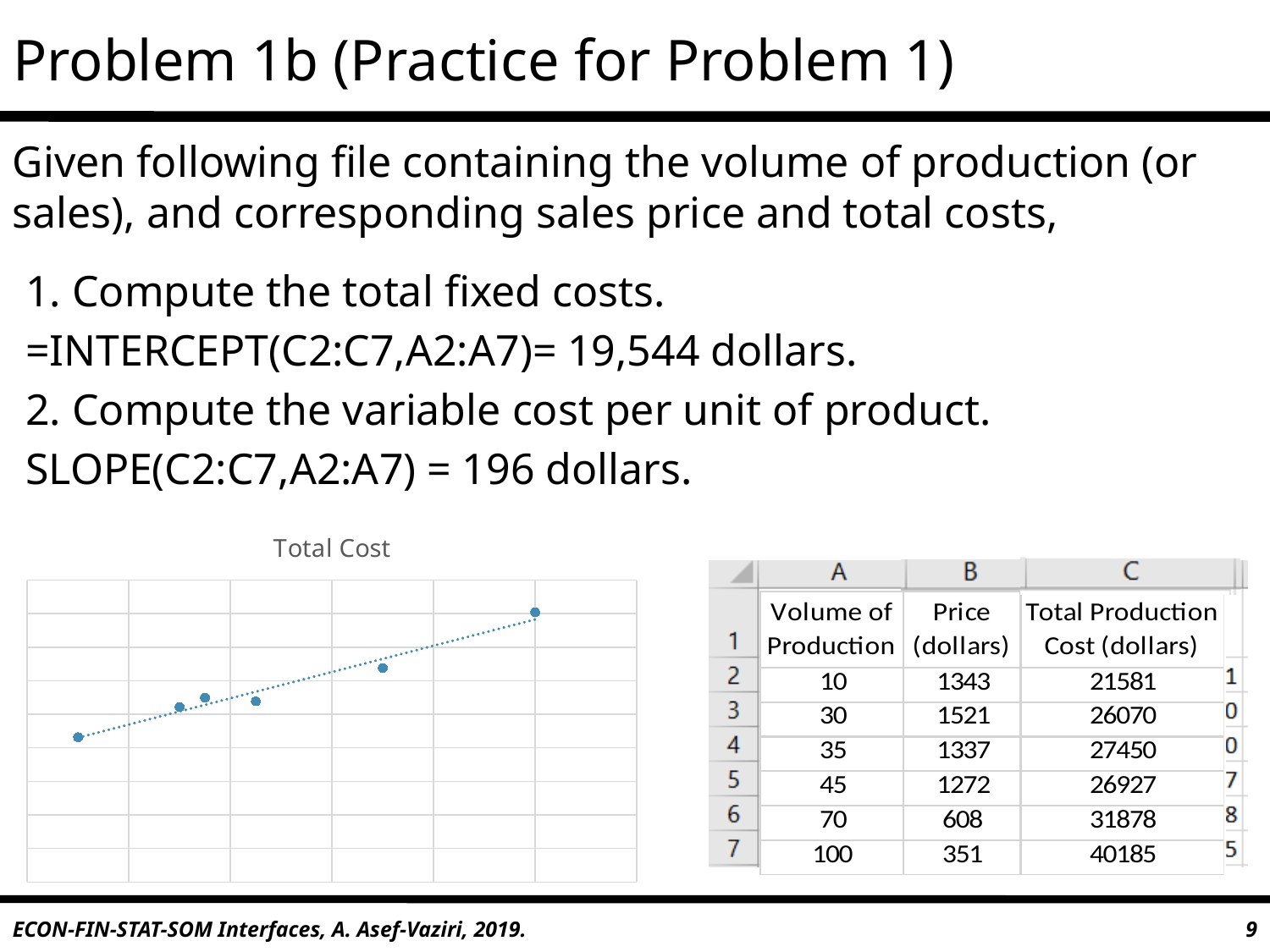
In the Total Cost chart, is the highest point the leftmost or the rightmost point? rightmost How many data points are plotted in the Total Cost chart? 6 Does the Total Cost chart include a trendline through the points? yes, a dotted trendline What kind of chart is shown on the slide? scatter chart What is the title of the chart on the slide? Total Cost In the Total Cost chart, is the lowest point the leftmost or the rightmost point? leftmost Do the values in the Total Cost chart rise or fall as you move from left to right along the x axis? rise In the Total Cost chart, is the rightmost point higher or lower than the leftmost point? higher